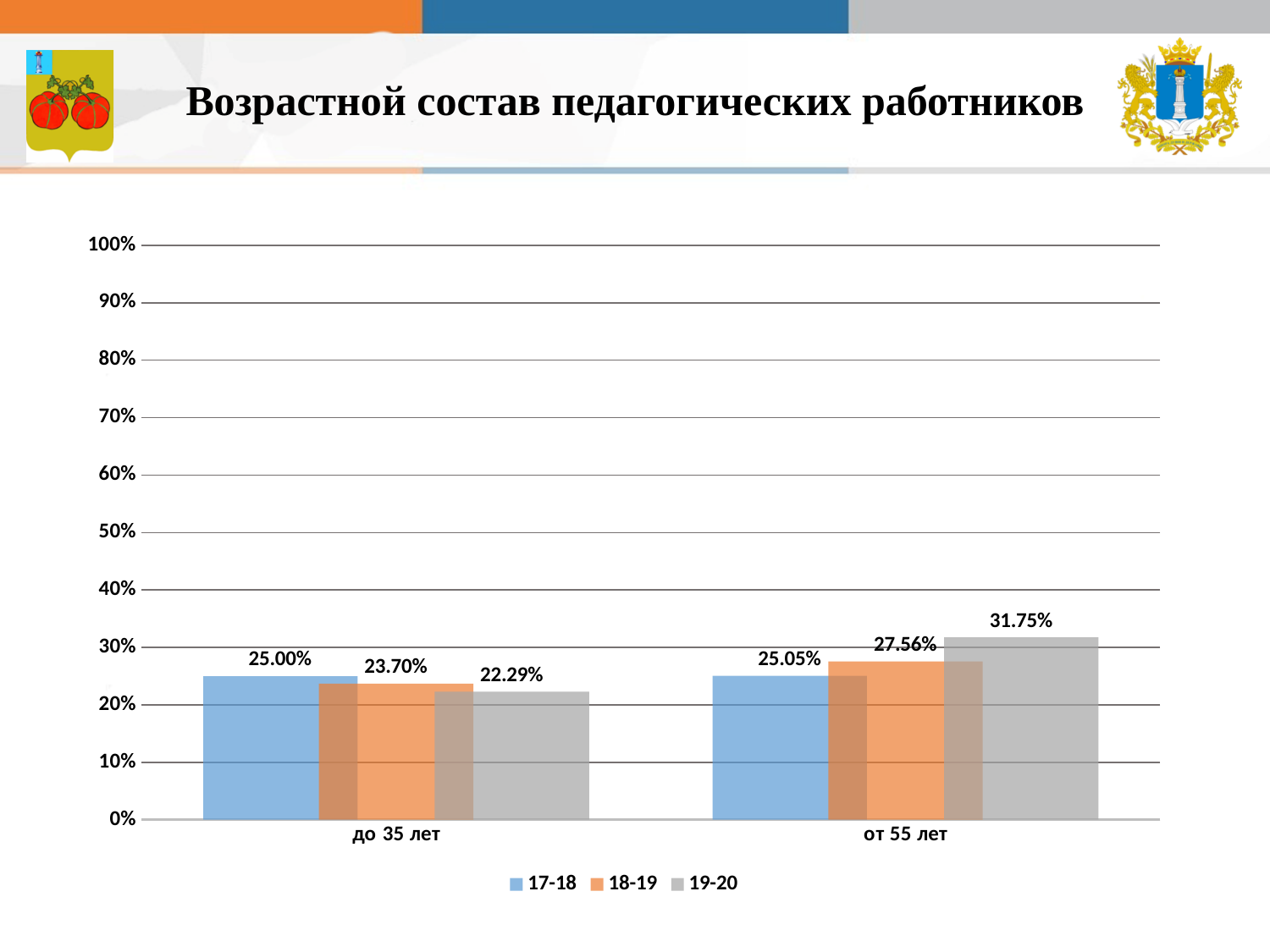
How many series does the legend list? 3 Do the values for the "до 35 лет" category rise or fall from 17-18 to 19-20? fall Which series has the lowest value in the "до 35 лет" category? 19-20 What is the value for 17-18 in the "до 35 лет" category? 25.00% What kind of chart is shown on the slide? bar chart What is the value for 19-20 in the "до 35 лет" category? 22.29% Which series has the highest value in the "от 55 лет" category? 19-20 What is the difference between the 19-20 value for "от 55 лет" and the 19-20 value for "до 35 лет"? 9.46% Is the value for 19-20 in "от 55 лет" greater or less than 30%? greater What is the value for 19-20 in the "от 55 лет" category? 31.75% Which is larger: the 18-19 value for "до 35 лет" or the 18-19 value for "от 55 лет"? от 55 лет What is the value for 18-19 in the "от 55 лет" category? 27.56%